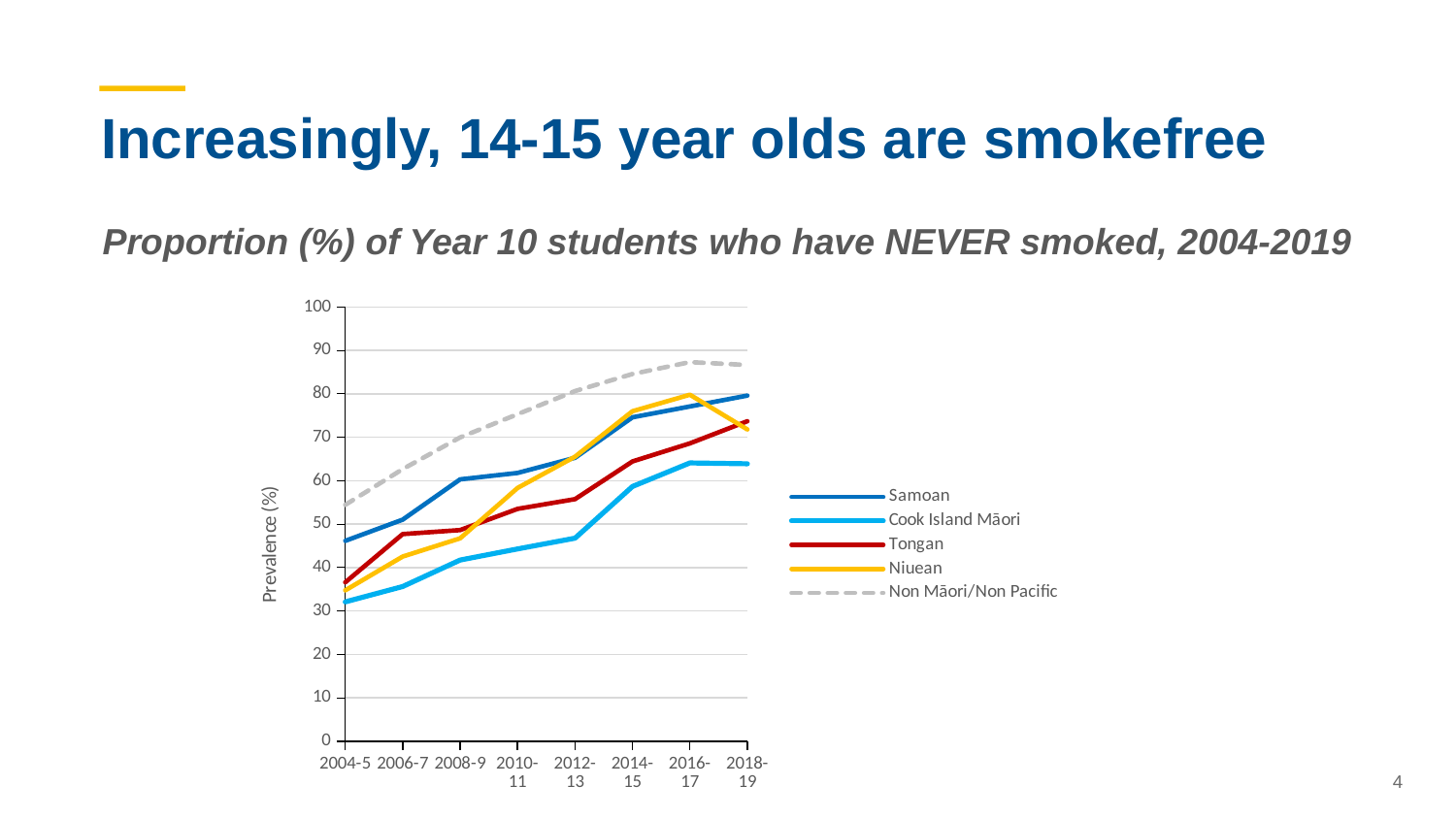
Is the value for Tongan in 2004-5 greater or less than 40? less Which series is drawn with a dashed line? Non Māori/Non Pacific What kind of chart is shown on the slide? Line chart In 2016-17, which is larger: the value for Niuean or the value for Cook Island Māori? Niuean Is the value for Samoan in 2004-5 greater or less than 40? greater Does the Samoan series generally rise or fall from 2004-5 to 2018-19? Rise How many series does the legend list? 5 Which series has the lowest value in 2018-19? Cook Island Māori Is the value for Cook Island Māori in 2018-19 greater or less than 60? greater Which series has the highest value in 2018-19? Non Māori/Non Pacific How many time periods are shown along the x axis? 8